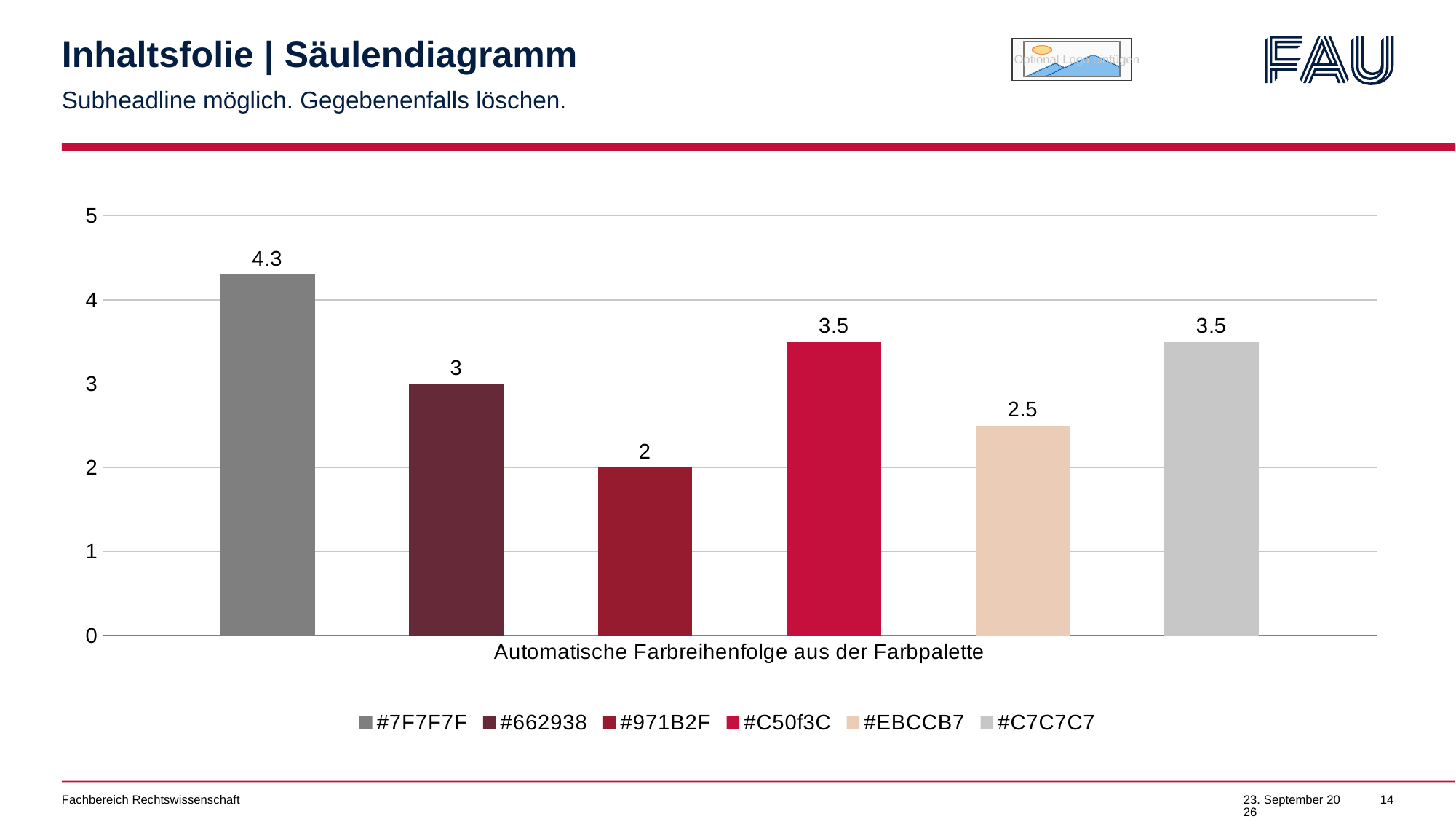
Which is larger, the value for #662938 or the value for #EBCCB7? #662938 Which series has the lowest value? #971B2F What is the value for the #7F7F7F series? 4.3 What is the category label shown on the x axis? Automatische Farbreihenfolge aus der Farbpalette What is the value for the #EBCCB7 series? 2.5 How many series does the legend list? 6 What is the value for the #C7C7C7 series? 3.5 What kind of chart is shown on the slide? bar chart Which series has the highest value? #7F7F7F Is the value for #C50f3C greater or less than 3? greater What is the difference between the values for #7F7F7F and #971B2F? 2.3 What is the value for the #662938 series? 3